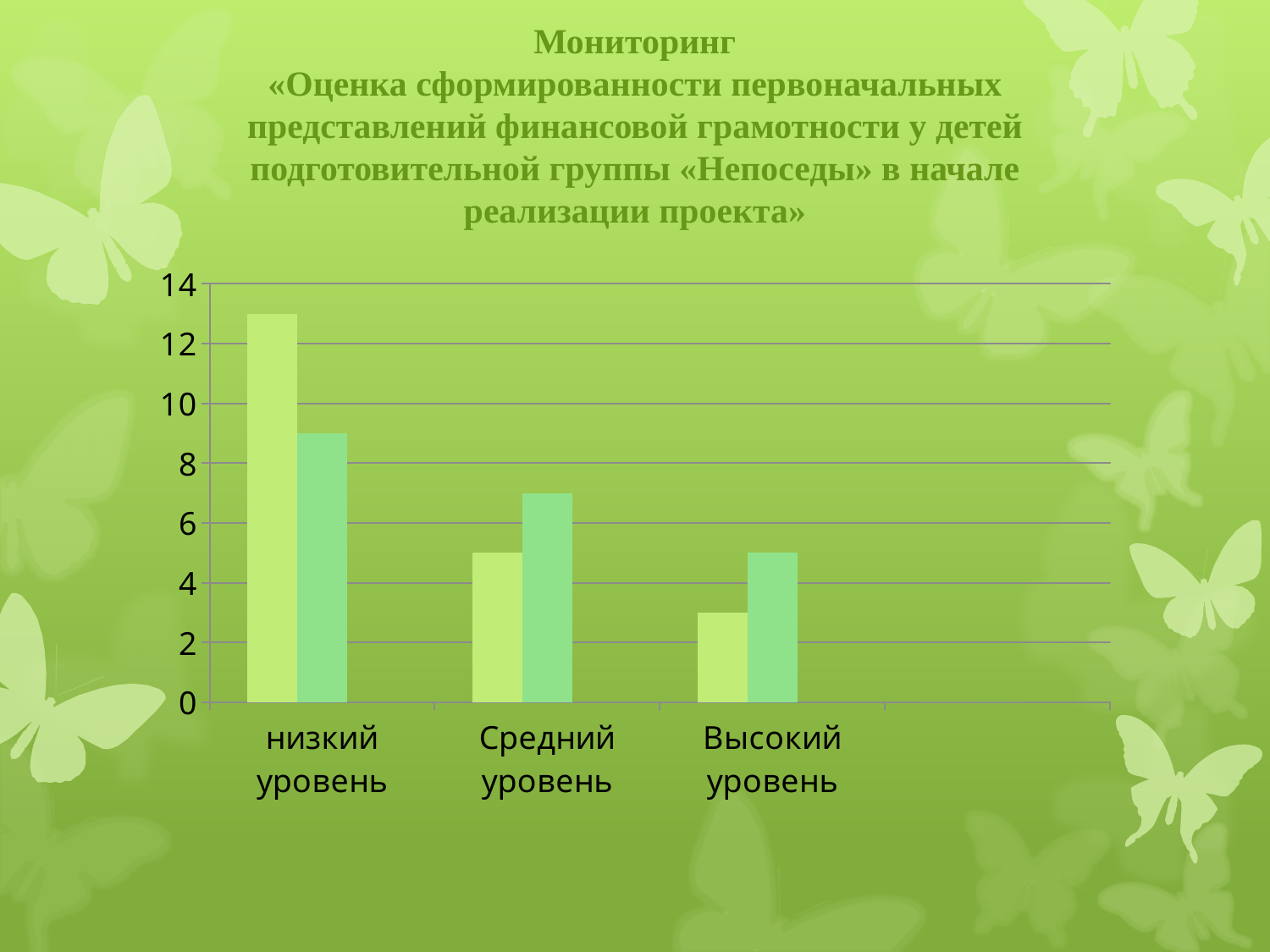
Do the lighter (yellow-green) bars rise or fall from низкий уровень to Высокий уровень? fall Which category has the shortest bar in the chart? Высокий уровень Which category has the tallest bar in the chart? низкий уровень Is the lighter (yellow-green) bar for Высокий уровень greater or less than 4? less For Средний уровень, which bar is taller: the lighter (yellow-green) bar or the darker green bar? the darker green bar Does the chart display a legend? No Is the darker green bar for Средний уровень greater or less than 6? greater Is the darker green bar for низкий уровень greater or less than 10? less What kind of chart is shown on the slide? bar chart How many categories are shown on the x axis of the chart? 3